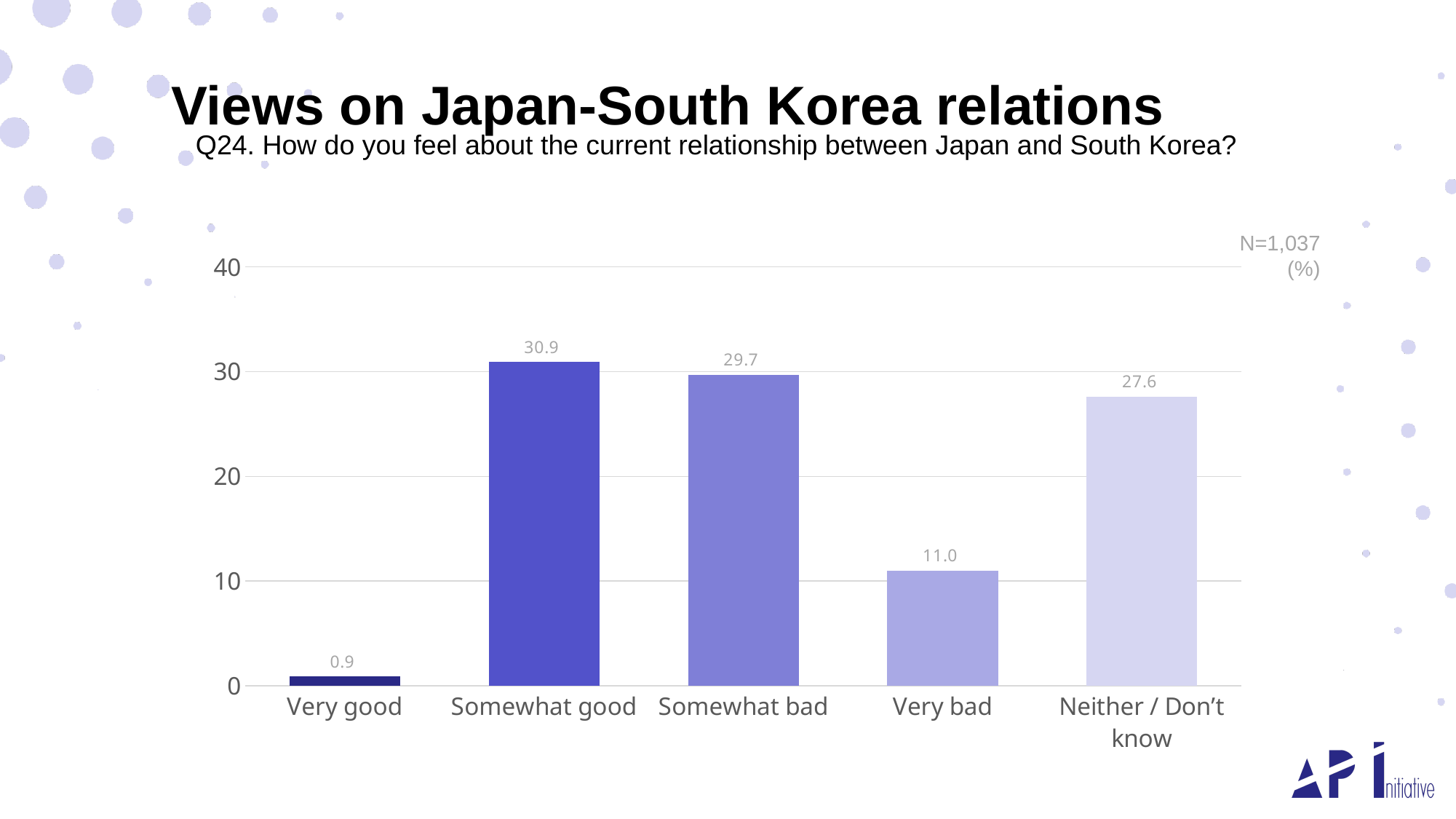
What is the value for Neither / Don't know? 27.6 Which category has the lowest value? Very good What is the sample size (N) shown on the chart? N=1,037 Is the value for Somewhat bad greater or less than 20? greater Which category has the highest value? Somewhat good What is the value for Very bad? 11.0 Which is larger, the value for Very bad or the value for Neither / Don't know? Neither / Don't know What kind of chart is shown on the slide? bar chart What is the difference between the values for Somewhat good and Somewhat bad? 1.2 How many categories are shown on the x axis? 5 What is the difference between the values for Very bad and Very good? 10.1 What is the value for Somewhat good? 30.9